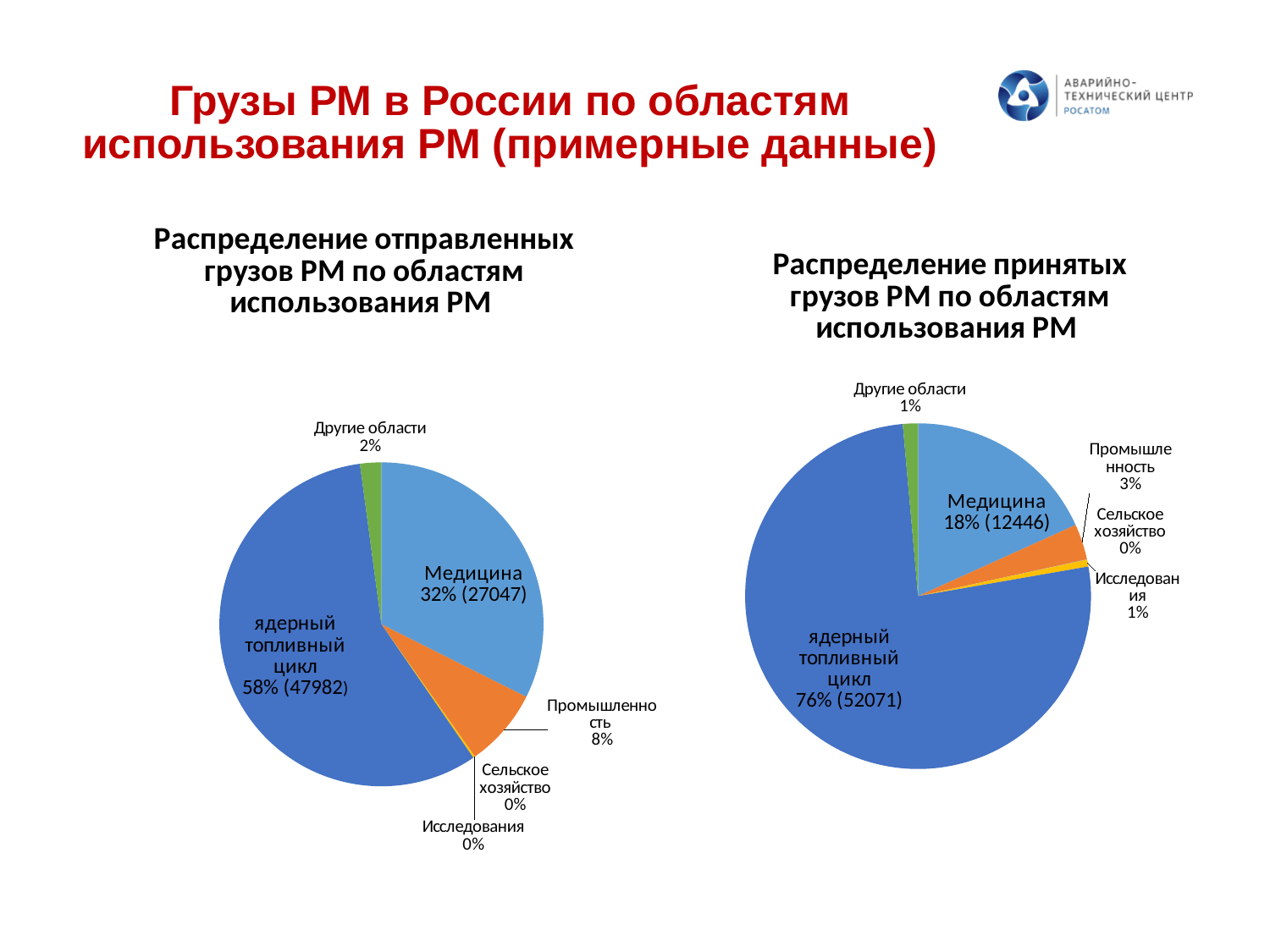
In the left chart (отправленных грузов), what share does Медицина have? 32% In the left chart (отправленных грузов), what share does Промышленность have? 8% In the right chart (принятых грузов), which category has the smallest slice? Сельское хозяйство In the right chart (принятых грузов), what share does ядерный топливный цикл have? 76% In the left chart (отправленных грузов), which category has the largest slice? ядерный топливный цикл What kind of chart is the left chart, 'Распределение отправленных грузов РМ по областям использования РМ'? pie chart In the right chart (принятых грузов), what is the difference between the values in parentheses for ядерный топливный цикл and Медицина? 39625 In the left chart (отправленных грузов), what is the difference in percentage points between ядерный топливный цикл and Медицина? 26 In the left chart (отправленных грузов), what value is shown in parentheses for ядерный топливный цикл? 47982 In the left chart (отправленных грузов), how many categories are shown? 6 In the right chart (принятых грузов), which is larger: Промышленность or Другие области? Промышленность In the right chart (принятых грузов), what value is shown in parentheses for Медицина? 12446